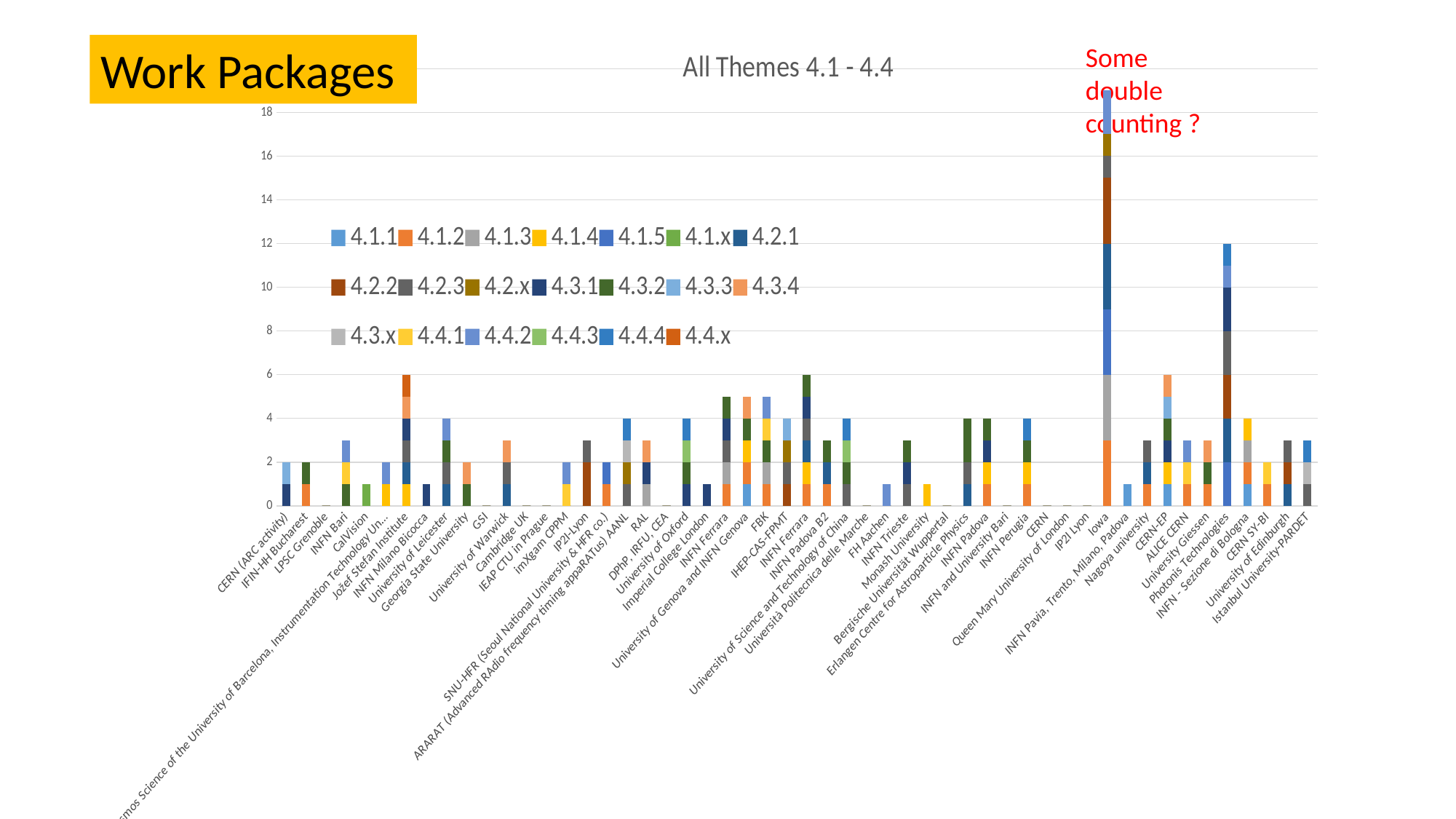
What does the red annotation text near the top right of the chart say? Some double counting ? What is the total height of the stacked bar for Photonis Technologies? 12 How many series does the chart legend list? 20 Which has the larger total, Iowa or Photonis Technologies? Iowa Which institution has the tallest stacked bar? Iowa Is the total for Photonis Technologies greater or less than 10? greater Is the total for Jožef Stefan Institute greater or less than 4? greater What is the title of the chart? All Themes 4.1 - 4.4 Is the total for Iowa greater or less than 16? greater Which has the larger total, Photonis Technologies or INFN Ferrara? Photonis Technologies What kind of chart is shown on the slide? Stacked bar chart